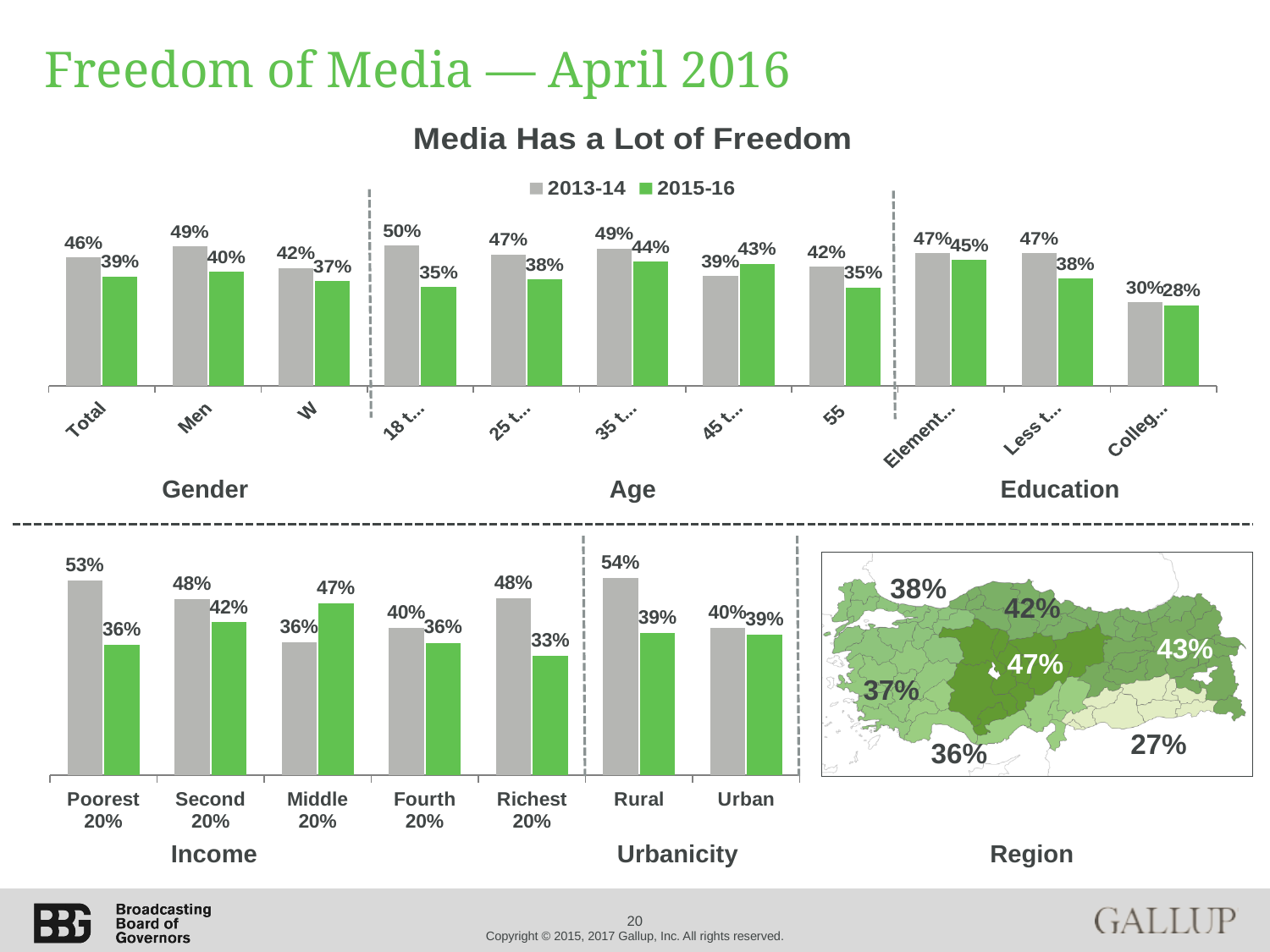
In the top chart, which of the two series is larger for Total, 2013-14 or 2015-16? 2013-14 How many series does the legend of the top chart list? 2 In the top chart, what is the 2015-16 value for Total? 39% In the bottom-left chart, which income category has the highest 2013-14 value? Poorest 20% In the bottom-left chart, what is the difference between the 2013-14 and 2015-16 values for Poorest 20%? 17% In the top chart, what is the 2013-14 value for Men? 49% In the bottom-left chart, what is the 2013-14 value for Rural? 54% What kind of chart is the top chart titled 'Media Has a Lot of Freedom'? bar chart In the bottom-left chart, which is larger for Middle 20%, the 2013-14 value or the 2015-16 value? 2015-16 How many categories are shown in the bottom-left chart covering Income and Urbanicity? 7 In the top chart, what is the difference between the 2013-14 and 2015-16 values for Men? 9% In the bottom-left chart, which income category has the lowest 2015-16 value? Richest 20%